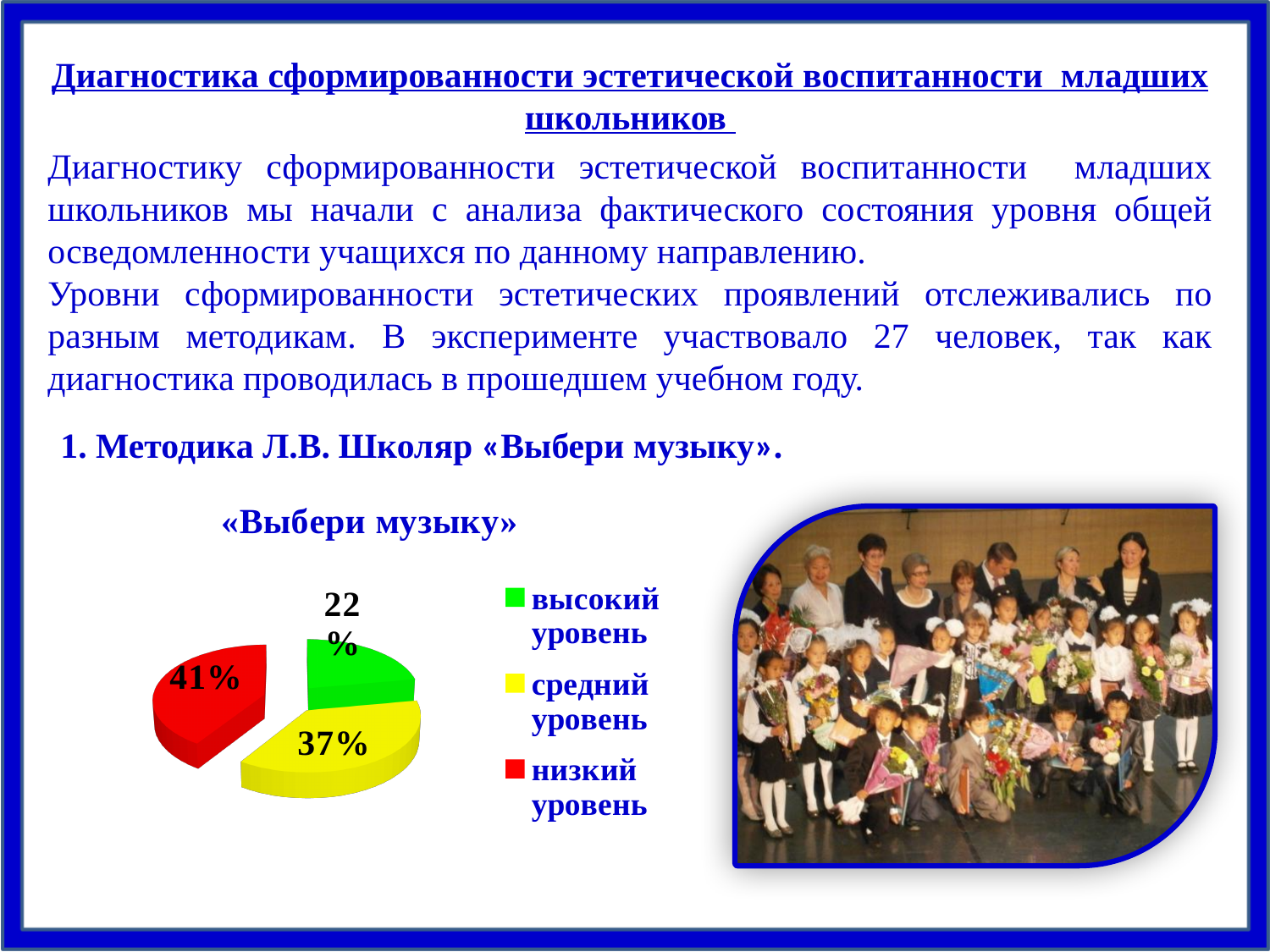
What is the difference between the средний уровень and высокий уровень values in the «Выбери музыку» pie chart? 15% Which level has the smallest slice in the «Выбери музыку» pie chart? высокий уровень What colour is the slice for средний уровень in the «Выбери музыку» pie chart? yellow What is the difference between the низкий уровень and высокий уровень values in the «Выбери музыку» pie chart? 19% What kind of chart is shown under the title «Выбери музыку»? pie chart Which level has the largest slice in the «Выбери музыку» pie chart? низкий уровень What is the value for низкий уровень in the «Выбери музыку» pie chart? 41% What is the title of the pie chart on the slide? «Выбери музыку» Which is larger in the «Выбери музыку» pie chart: средний уровень or низкий уровень? низкий уровень What is the value for высокий уровень in the «Выбери музыку» pie chart? 22% How many slices does the «Выбери музыку» pie chart have? 3 What is the value for средний уровень in the «Выбери музыку» pie chart? 37%